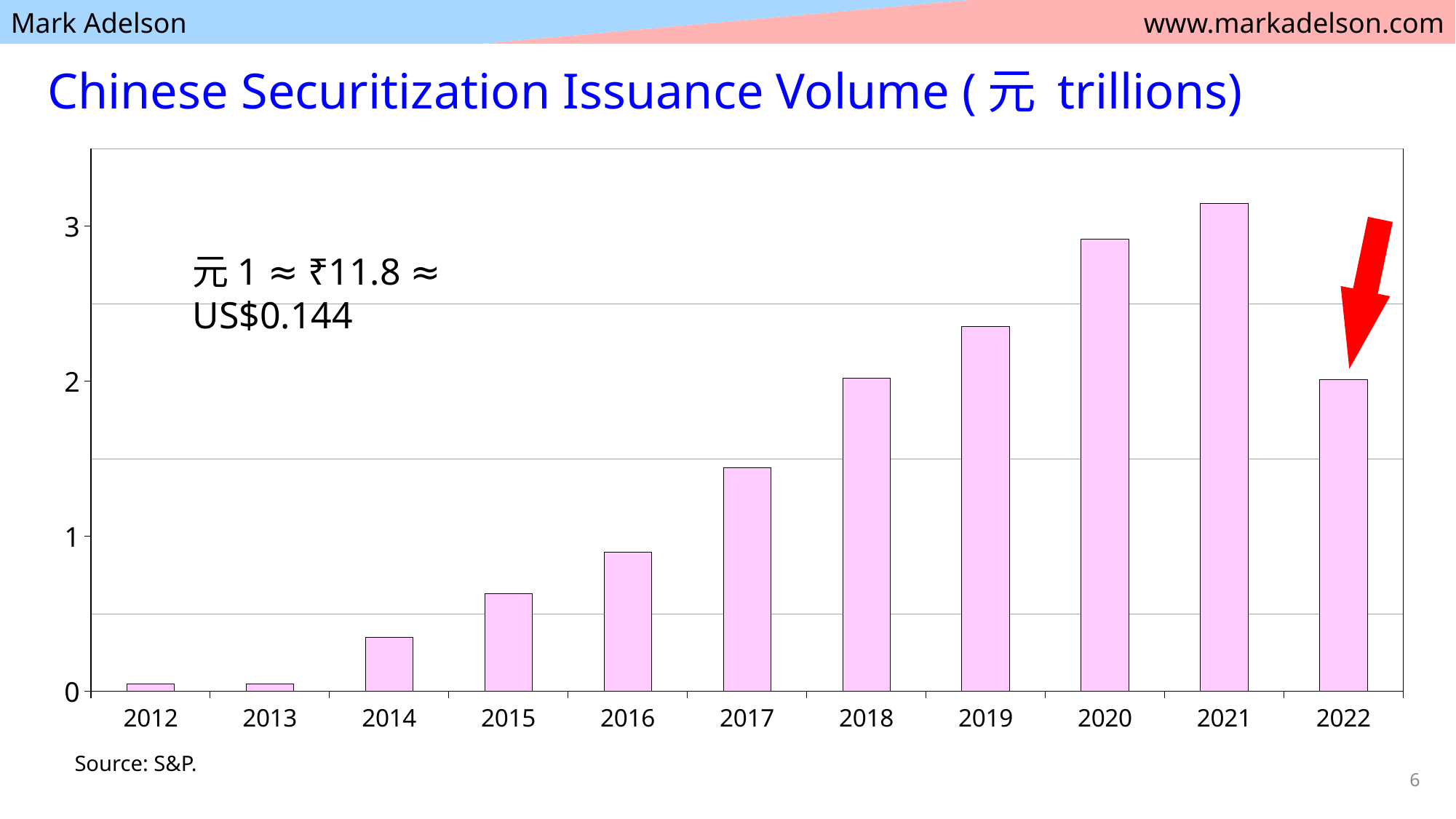
What kind of chart is shown on the slide? bar chart What is the source cited for the chart data? S&P Which year has the highest Chinese securitization issuance volume? 2021 Which year has the larger issuance volume, 2019 or 2020? 2020 How many years are shown on the x axis of the chart? 11 Is the issuance volume for 2019 greater or less than 2 trillion? greater Is the issuance volume for 2021 greater or less than 3 trillion? greater Is the issuance volume for 2020 greater or less than 3 trillion? less Do the issuance volumes generally rise or fall from 2012 to 2021? rise Which year has the larger issuance volume, 2021 or 2022? 2021